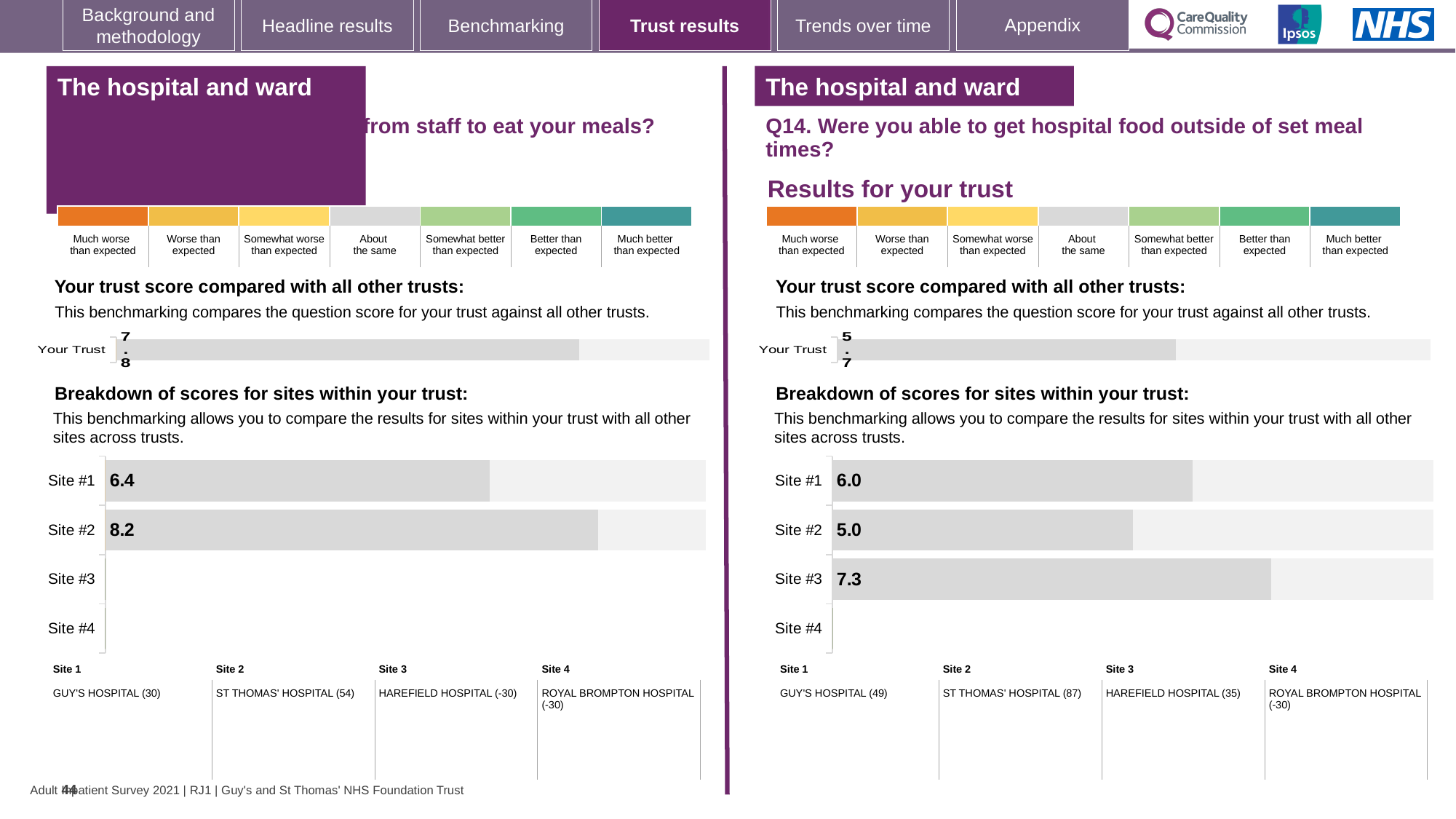
On the right-hand chart for Q14, which of the sites with a plotted bar has the lowest score? Site #2 On the left-hand chart, what is the 'Your Trust' score? 7.8 On the right-hand chart for Q14, what is the score for Site #3? 7.3 On the left-hand site breakdown chart, what is the score for Site #2? 8.2 On the right-hand chart for Q14, how many sites have a plotted bar? 3 On the right-hand chart for Q14, what is the 'Your Trust' score? 5.7 On the left-hand site breakdown chart, what is the score for Site #1? 6.4 What kind of chart is used for the site breakdown on the right-hand side of the slide? Bar chart On the left-hand site breakdown chart, which site has the higher score, Site #1 or Site #2? Site #2 On the right-hand chart for Q14 (hospital food outside of set meal times), what is the score for Site #1? 6.0 On the right-hand chart for Q14, which site has the highest score? Site #3 On the right-hand chart for Q14, what is the difference between the scores for Site #3 and Site #2? 2.3